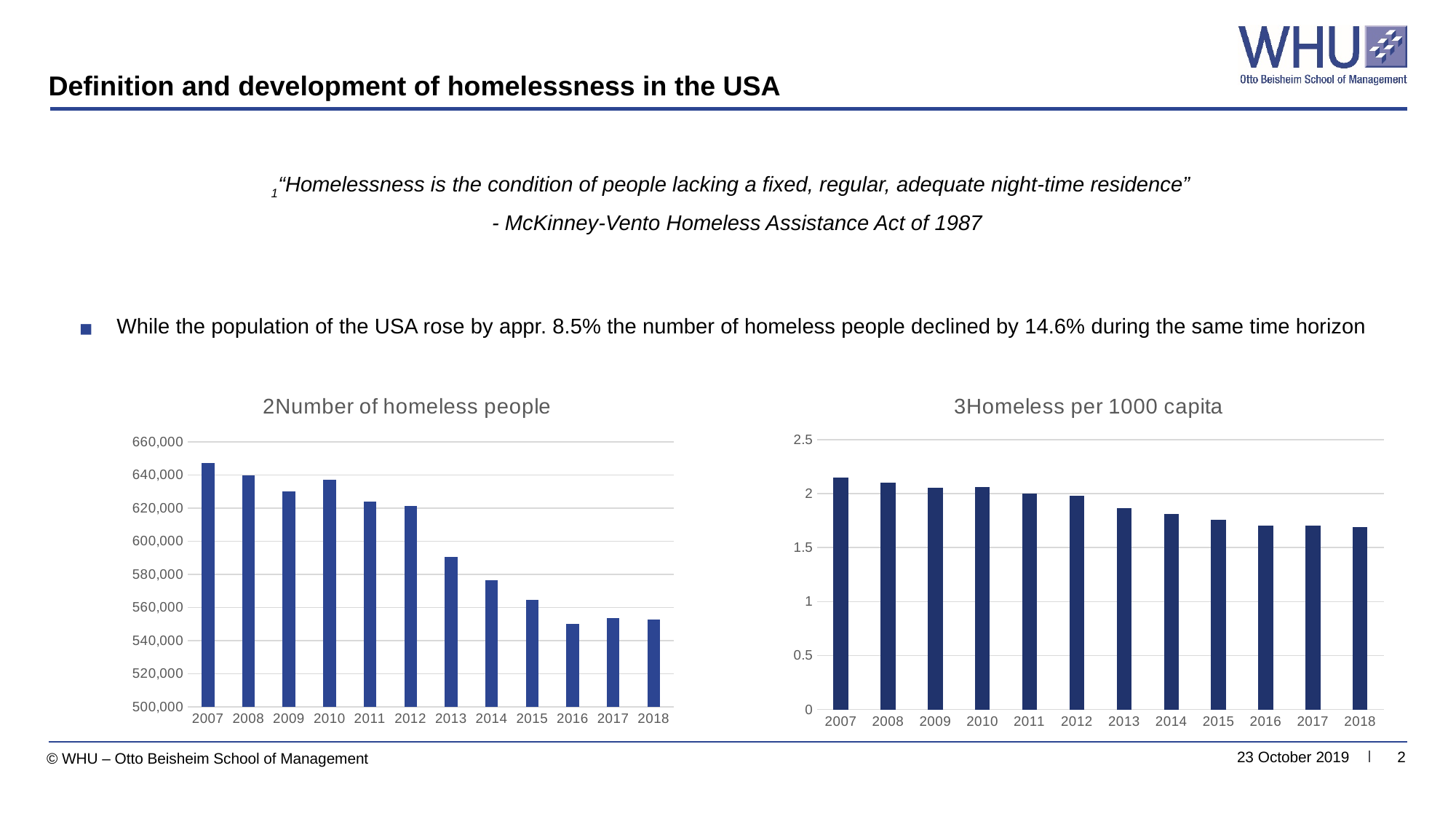
In the 'Number of homeless people' chart, is the value for 2014 greater or less than 580,000? less In the 'Homeless per 1000 capita' chart, which year has the highest value? 2007 In the 'Homeless per 1000 capita' chart, is the value for 2013 greater or less than 2? less In the 'Number of homeless people' chart, which year has the highest value? 2007 In the 'Number of homeless people' chart, do the values generally rise or fall from 2007 to 2018? fall In the 'Number of homeless people' chart, is the value for 2013 greater or less than 600,000? less How many years are shown on the x axis of the 'Homeless per 1000 capita' chart? 12 What kind of chart is the 'Number of homeless people' chart? bar chart In the 'Homeless per 1000 capita' chart, which is larger, the value for 2013 or the value for 2015? 2013